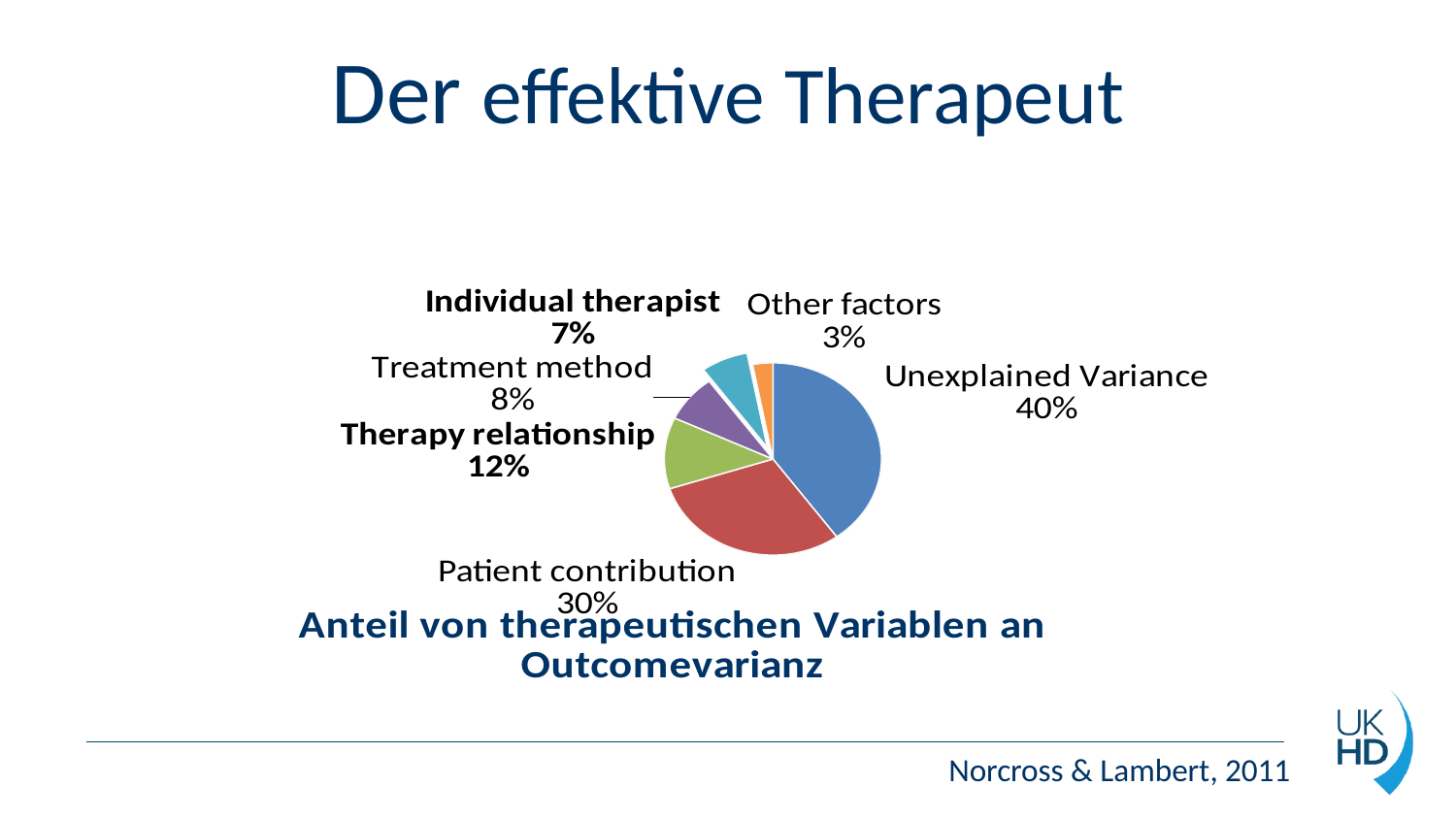
What kind of chart is shown on the slide? pie chart What share of outcome variance is attributed to Patient contribution? 30% What share of outcome variance is attributed to Unexplained Variance? 40% Which is larger, the share for Treatment method or the share for Individual therapist? Treatment method How many slices does the pie chart have? 6 What share of outcome variance is attributed to Therapy relationship? 12% What is the title of the pie chart? Anteil von therapeutischen Variablen an Outcomevarianz What is the difference between the shares for Patient contribution and Therapy relationship? 18% Which slice of the pie chart is the largest? Unexplained Variance What share of outcome variance is attributed to Treatment method? 8% What share of outcome variance is attributed to Individual therapist? 7% Which slice of the pie chart is the smallest? Other factors